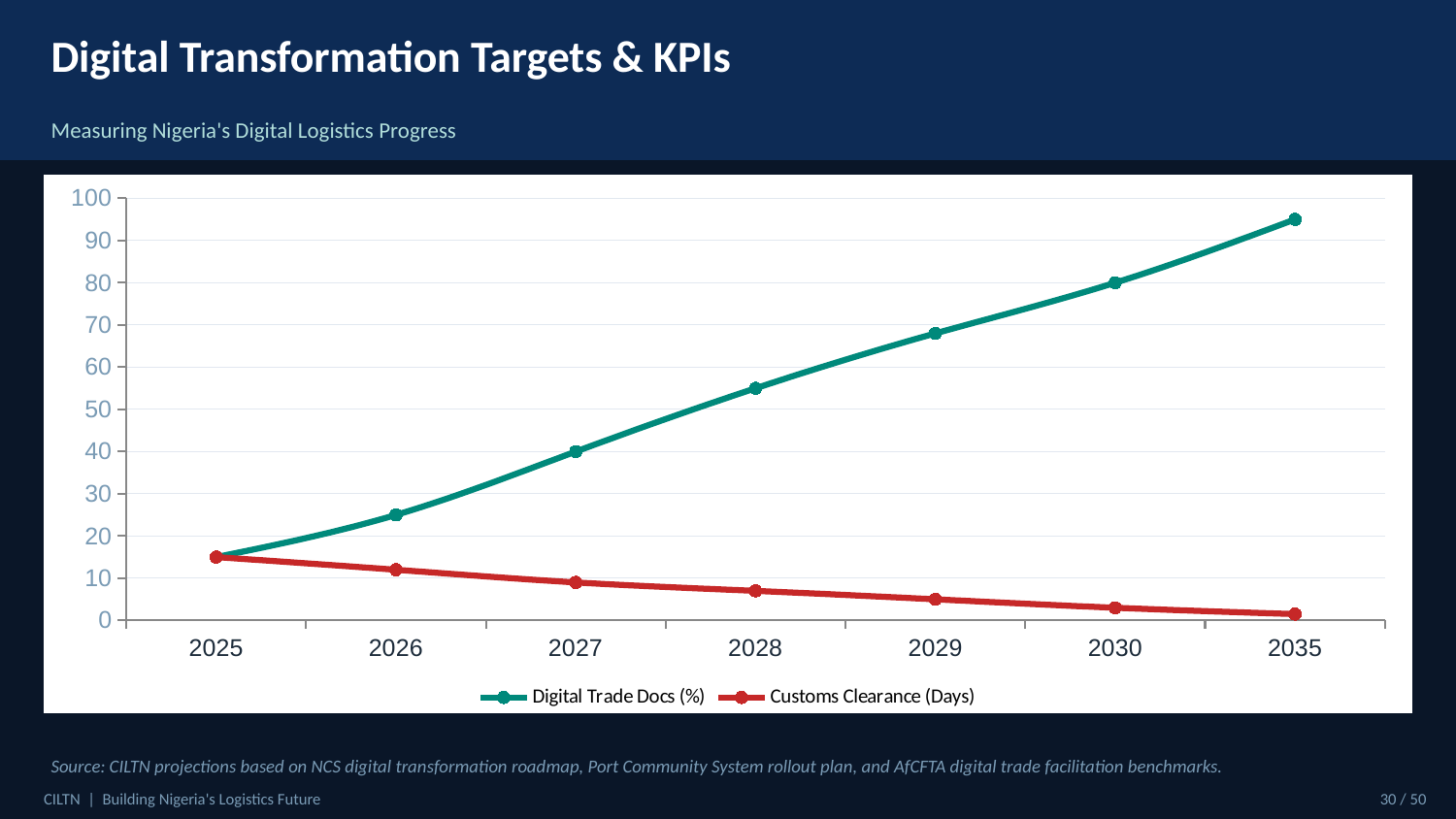
What colour is the Customs Clearance (Days) line? Red What kind of chart is shown on the slide? Line chart Is the Digital Trade Docs (%) value for 2028 greater or less than 50? greater What is the Digital Trade Docs (%) value for 2027? 40 Do the Customs Clearance (Days) values rise or fall from 2025 to 2035? Fall In which year is the Customs Clearance (Days) value lowest? 2035 In 2029, which series has the larger value, Digital Trade Docs (%) or Customs Clearance (Days)? Digital Trade Docs (%) How many series does the legend list? 2 Is the Customs Clearance (Days) value for 2026 greater or less than 10? greater Do the Digital Trade Docs (%) values rise or fall from 2025 to 2035? Rise How many years are plotted along the x axis? 7 In which year is the Digital Trade Docs (%) value highest? 2035